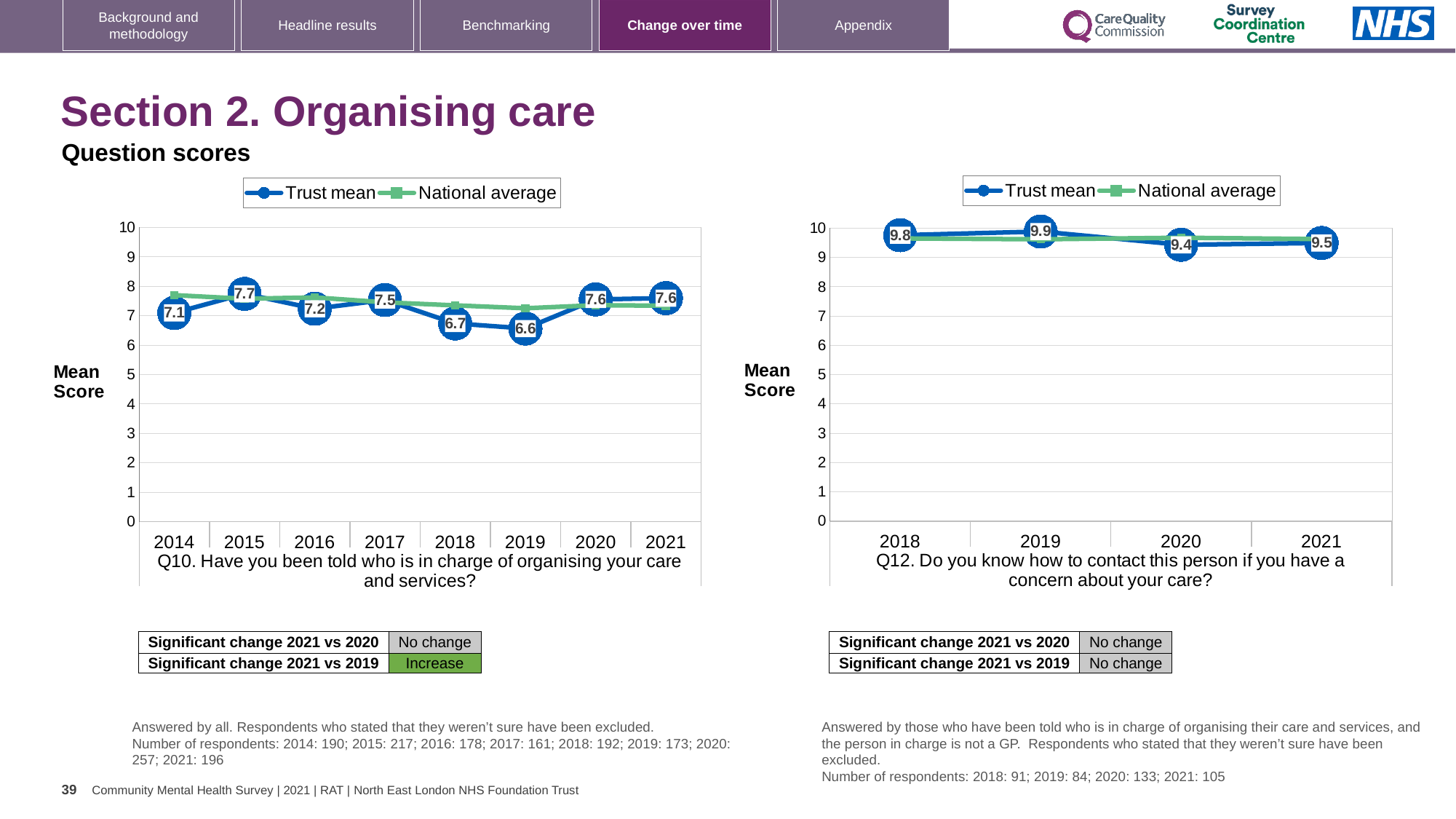
In the Q10 chart on the left, how many years are plotted on the x axis? 8 In the Q10 chart on the left, which year has the lowest Trust mean? 2019 In the Q10 chart on the left, what is the Trust mean for 2019? 6.6 In the Q12 chart on the right, which year has the highest Trust mean? 2019 What kind of chart is the Q10 chart on the left? Line chart In the Q12 chart on the right, what is the Trust mean for 2020? 9.4 In the Q12 chart on the right, what is the difference between the Trust mean in 2019 and in 2020? 0.5 How many series does the legend of the Q12 chart on the right list? 2 In the Q10 chart on the left, which year has the highest Trust mean? 2015 In the Q10 chart on the left, what is the difference between the Trust mean in 2015 and in 2019? 1.1 In the Q12 chart on the right, is the Trust mean for 2018 larger or smaller than the Trust mean for 2021? larger In the Q10 chart on the left, what is the Trust mean for 2015? 7.7